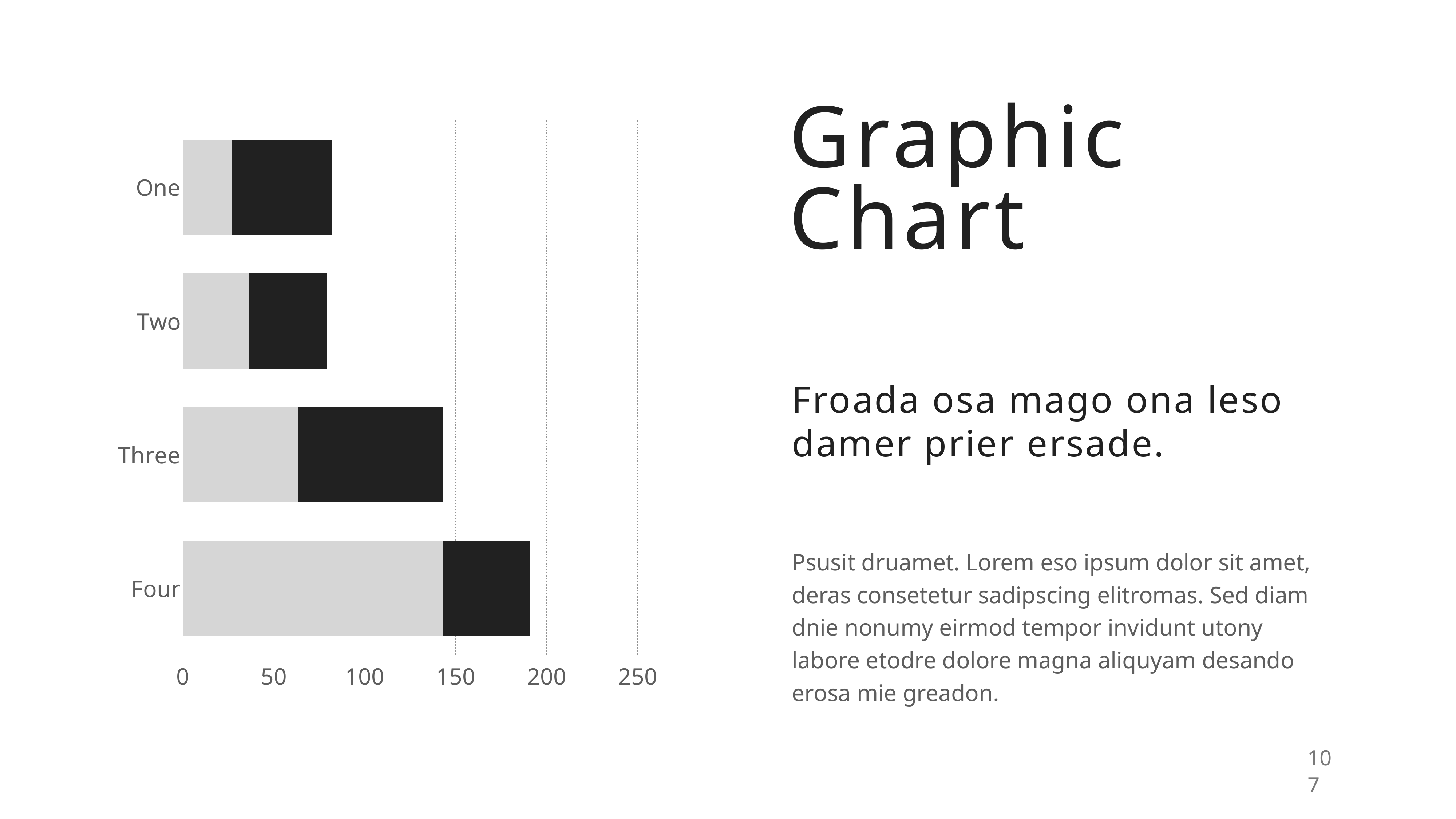
Which has the larger total bar, Three or Four? Four Is the total value for Four greater or less than 200? less What kind of chart is shown on the slide? bar chart Is the total value for Three greater or less than 100? greater How many categories are plotted on the chart? 4 Is the total value for Two greater or less than 100? less What are the two colours used for the bar segments? grey and black Which has the larger total bar, One or Three? Three What is the highest value shown on the horizontal axis? 250 Which category has the longest total bar? Four